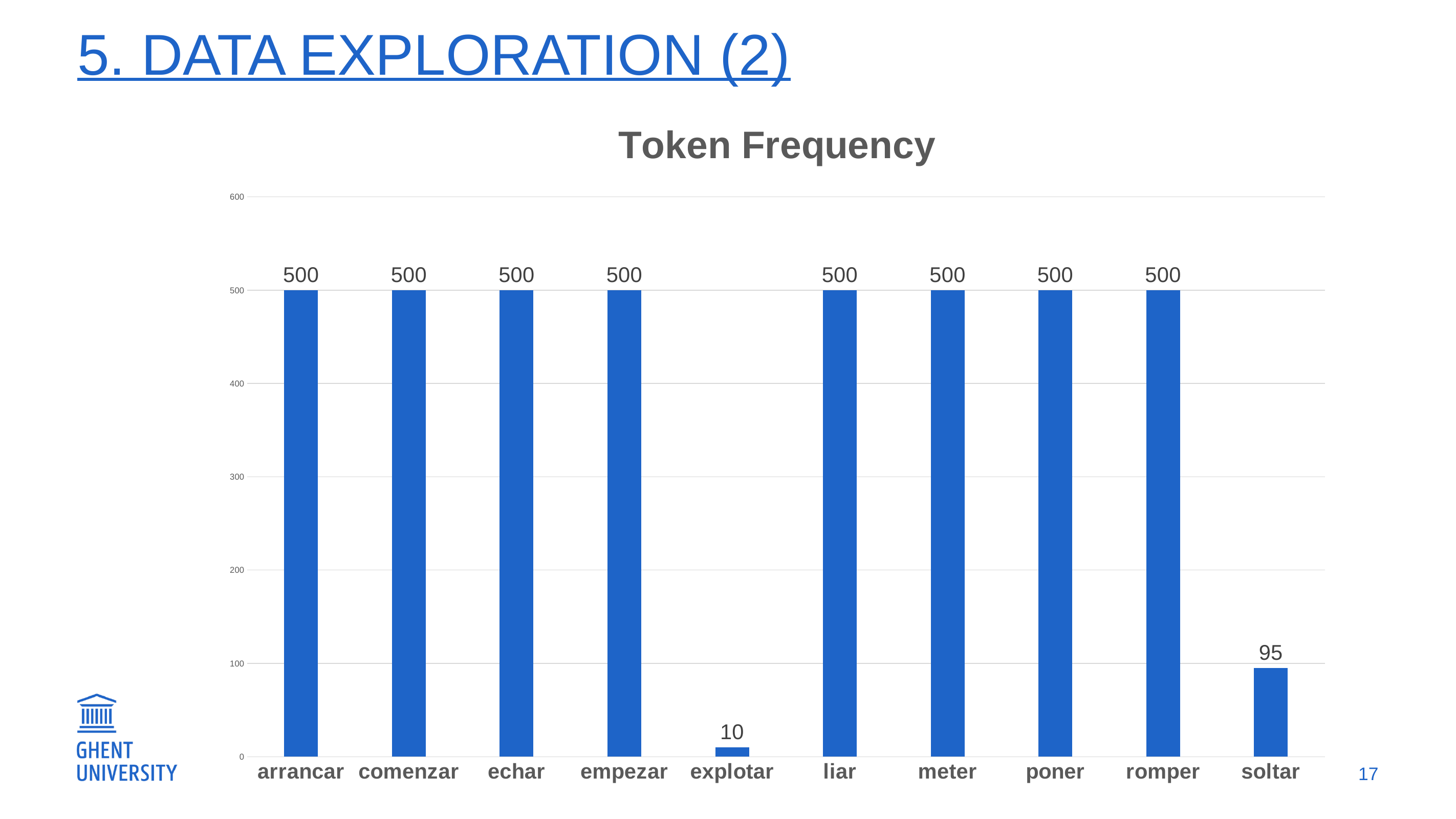
What is the token frequency for explotar? 10 What is the difference in token frequency between soltar and explotar? 85 What is the token frequency for soltar? 95 Is the value for soltar greater or less than 100? less How many categories are shown on the x axis? 10 What is the difference in token frequency between romper and soltar? 405 Which has a higher token frequency, soltar or explotar? soltar What is the token frequency for arrancar? 500 Which category has the lowest token frequency? explotar What is the title of the chart? Token Frequency Which has a higher token frequency, meter or soltar? meter What kind of chart is shown on the slide? bar chart